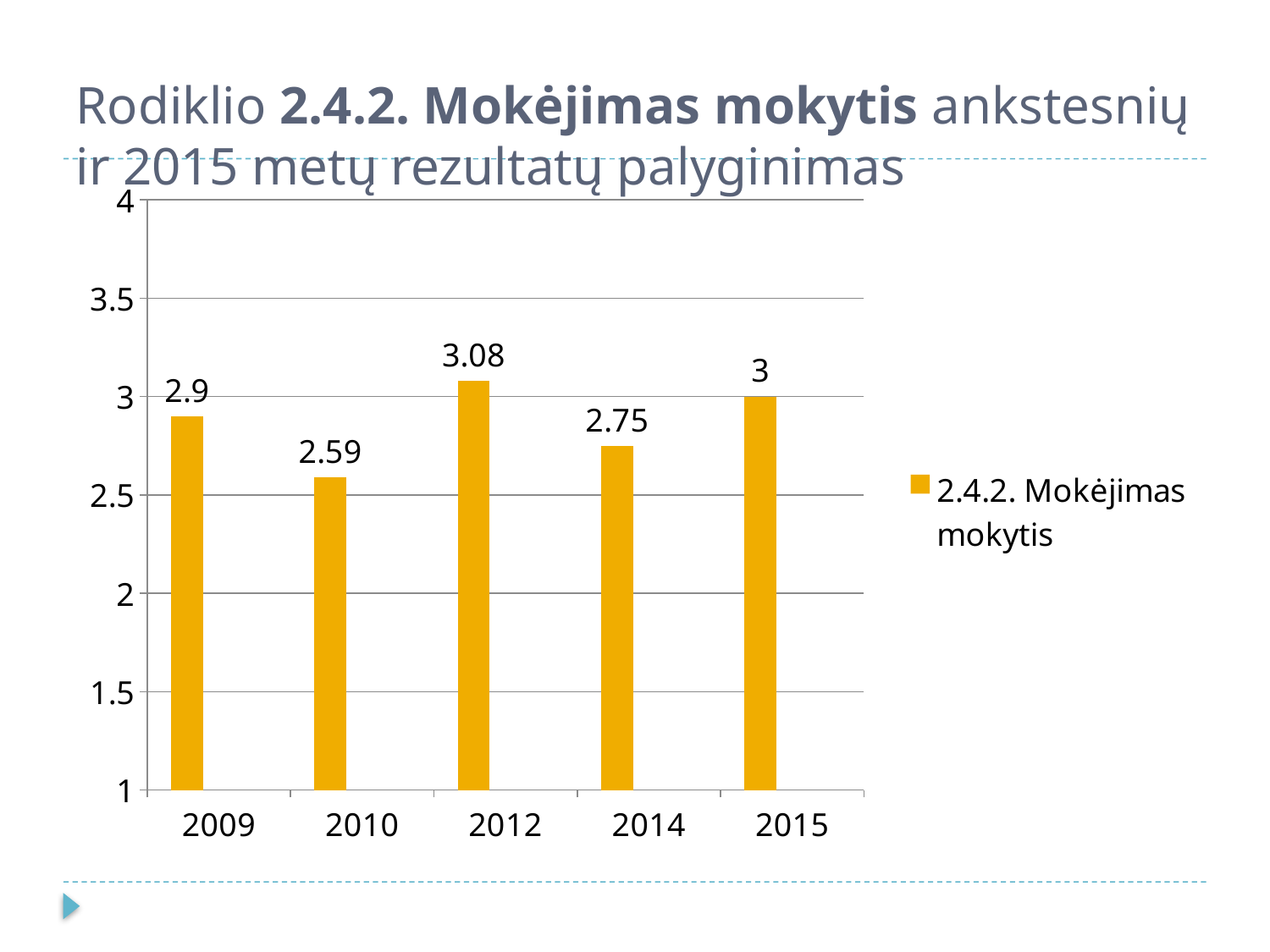
What is the value for 2009? 2.9 How many years are shown on the x axis? 5 Is the value for 2010 greater or less than 3? less What kind of chart is shown on the slide? bar chart Which year has the highest value? 2012 Which is larger, the value for 2009 or the value for 2014? 2009 What is the difference between the values for 2012 and 2010? 0.49 What is the value for 2015? 3 What is the legend entry for the series? 2.4.2. Mokėjimas mokytis What is the value for 2012? 3.08 Which year has the lowest value? 2010 How many series does the legend list? 1